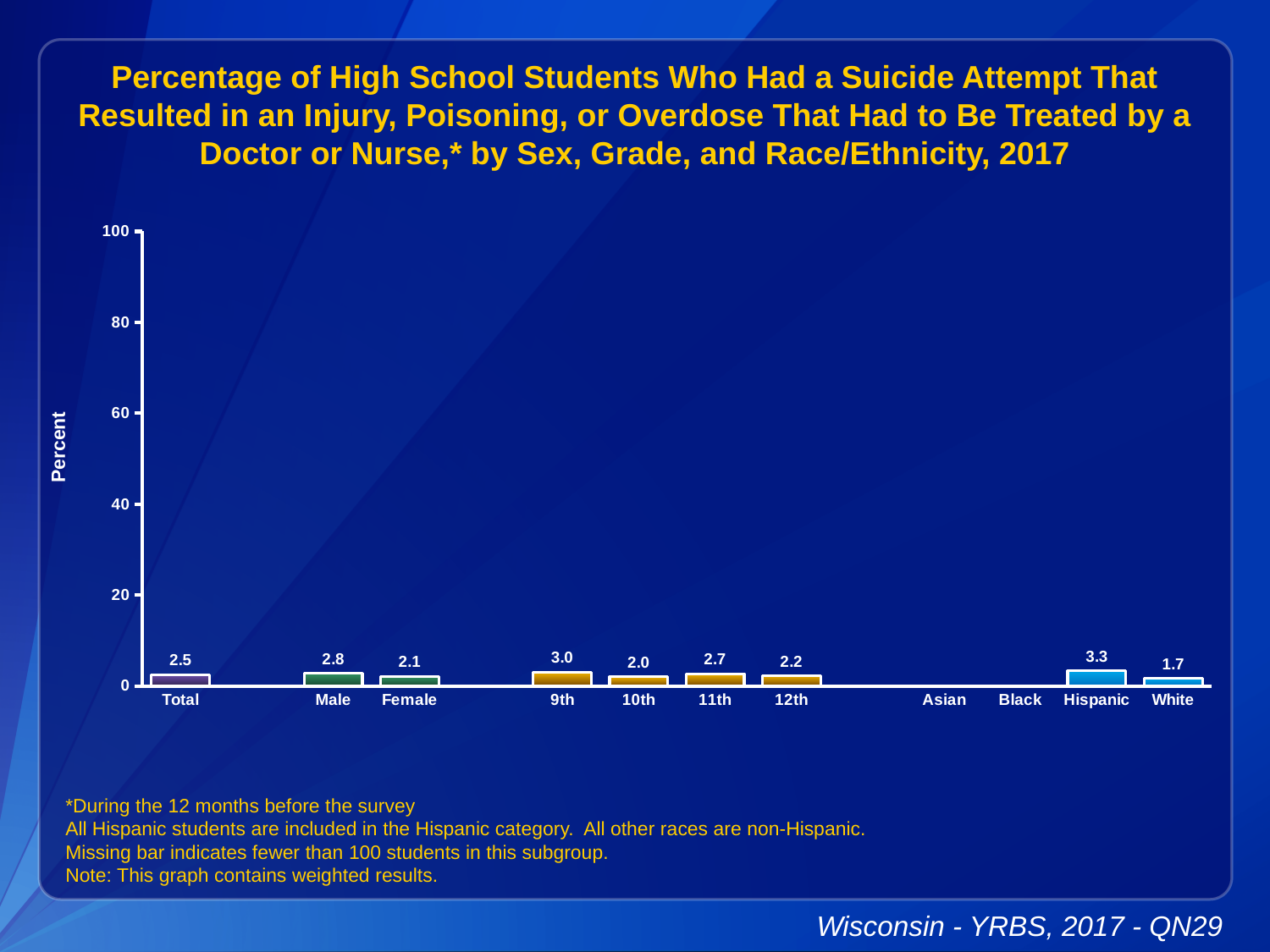
What kind of chart is shown? bar chart Which categories have no bar shown? Asian and Black What is the value for 10th grade? 2.0 Is the value for 11th grade greater or less than 20? less What is the value for Male? 2.8 How many categories are labeled on the x axis? 11 What is the value for Total? 2.5 Which category has the highest value? Hispanic What is the difference between the Male and Female values? 0.7 Which is larger, the value for 9th grade or 12th grade? 9th Which category with a bar has the lowest value? White What is the value for Hispanic? 3.3